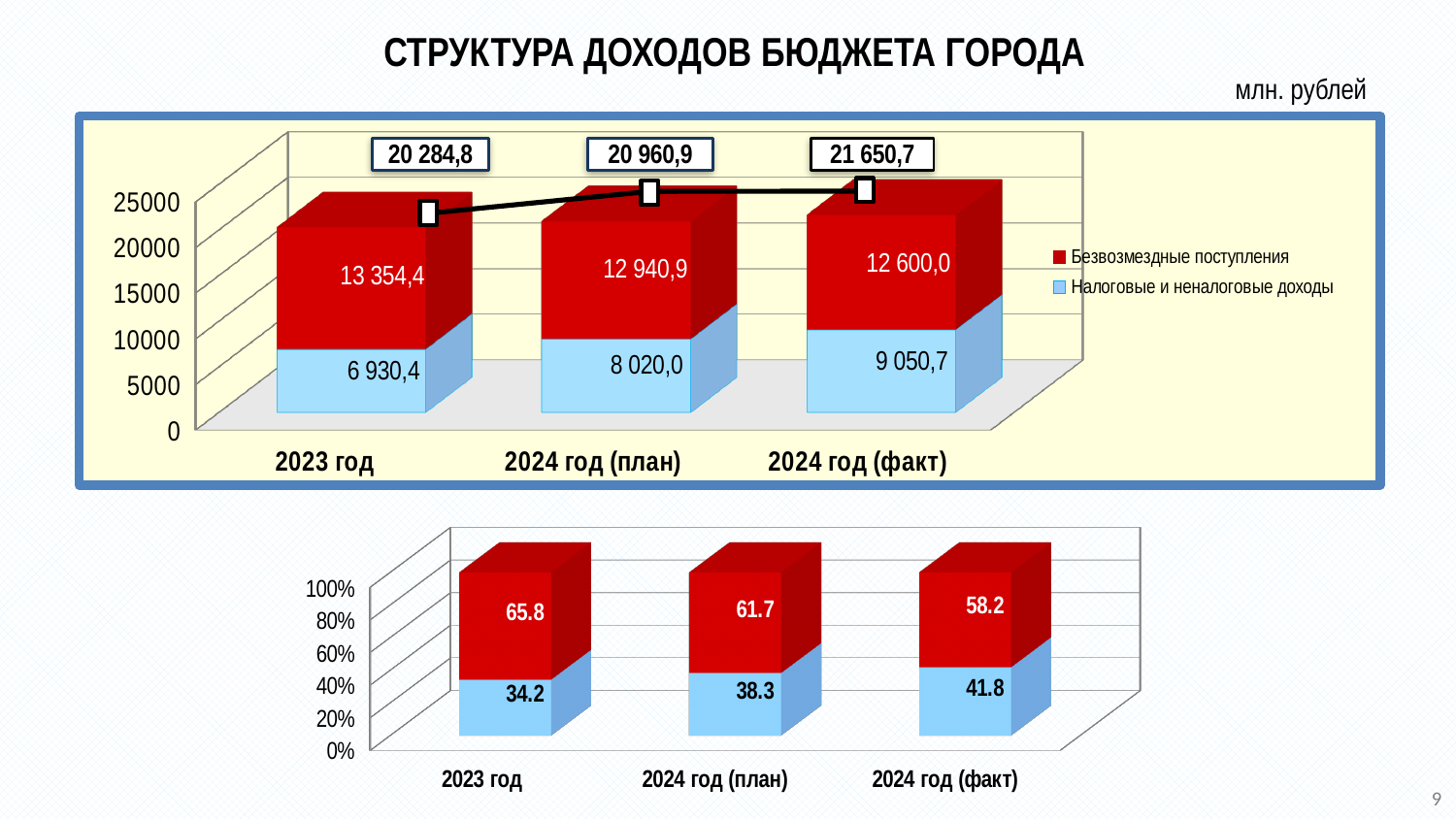
In the top chart, which category has the highest value for Налоговые и неналоговые доходы? 2024 год (факт) In the bottom chart, is the red segment for 2023 год larger or smaller than the red segment for 2024 год (факт)? larger In the top chart, what is the value of Безвозмездные поступления for 2023 год? 13 354,4 In the bottom chart, what is the share of Безвозмездные поступления (red) for 2024 год (план)? 61.7 What kind of chart is the bottom chart? Stacked bar chart In the top chart, how do the totals shown above the bars change from 2023 год to 2024 год (факт)? They rise How many series does the legend of the top chart list? 2 In the top chart, what is the difference between Налоговые и неналоговые доходы for 2024 год (план) and 2023 год? 1 089,6 In the bottom chart, which category has the highest value for the blue segment? 2024 год (факт) In the top chart, which category has the lowest value for Безвозмездные поступления? 2024 год (факт) In the top chart, what is the total shown above the bar for 2024 год (план)? 20 960,9 In the top chart, what is the value of Налоговые и неналоговые доходы for 2024 год (факт)? 9 050,7